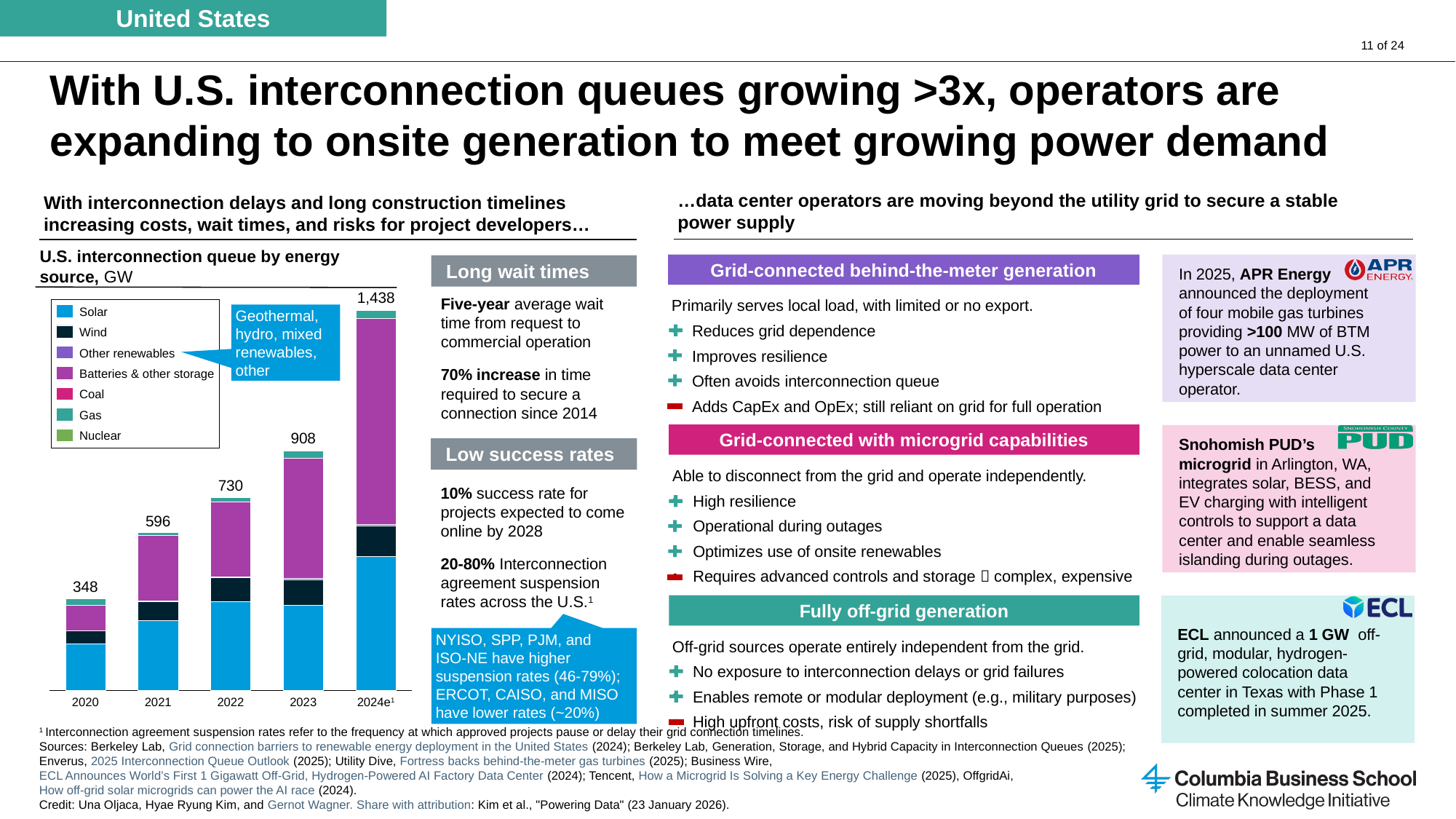
Which year has the lowest total interconnection queue in the chart? 2020 What is the total U.S. interconnection queue shown for 2022? 730 By how much did the total interconnection queue increase from 2023 to 2024e? 530 Which year has a larger total interconnection queue, 2021 or 2022? 2022 Does the total interconnection queue rise or fall from 2020 to 2024e? Rise Which year has the highest total interconnection queue in the chart? 2024e What is the difference between the 2021 and 2020 totals in the interconnection queue chart? 248 What is the total U.S. interconnection queue shown for 2020? 348 What is the total U.S. interconnection queue shown for 2024e? 1,438 How many years are shown on the x axis of the interconnection queue chart? 5 What kind of chart is used to show the U.S. interconnection queue by energy source? Stacked bar chart How many energy sources does the legend of the interconnection queue chart list? 7